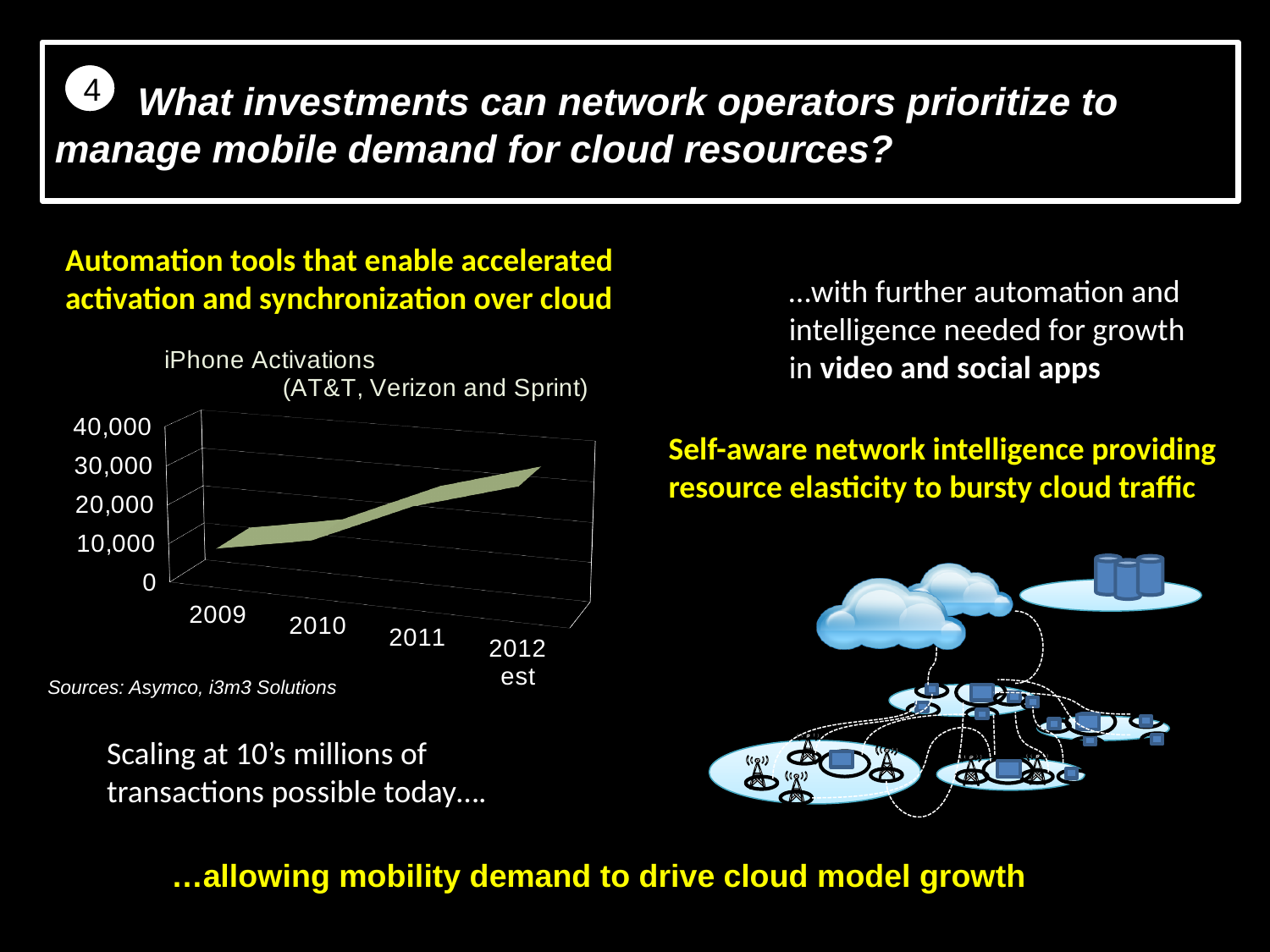
Which year has more iPhone activations, 2010 or 2011? 2011 What is the highest value shown on the y axis of the iPhone Activations chart? 40,000 How many years are shown on the x axis of the iPhone Activations chart? 4 Is the value for 2012 est greater or less than 20,000? greater Is the value for 2011 greater or less than 10,000? greater Which carriers are named in the title of the iPhone Activations chart? AT&T, Verizon and Sprint Which year has the highest iPhone activations? 2012 est What kind of chart is the iPhone Activations chart? line chart Is the value for 2009 greater or less than 20,000? less Which year has the lowest iPhone activations? 2009 Do iPhone activations rise or fall from 2009 to 2012 est? rise